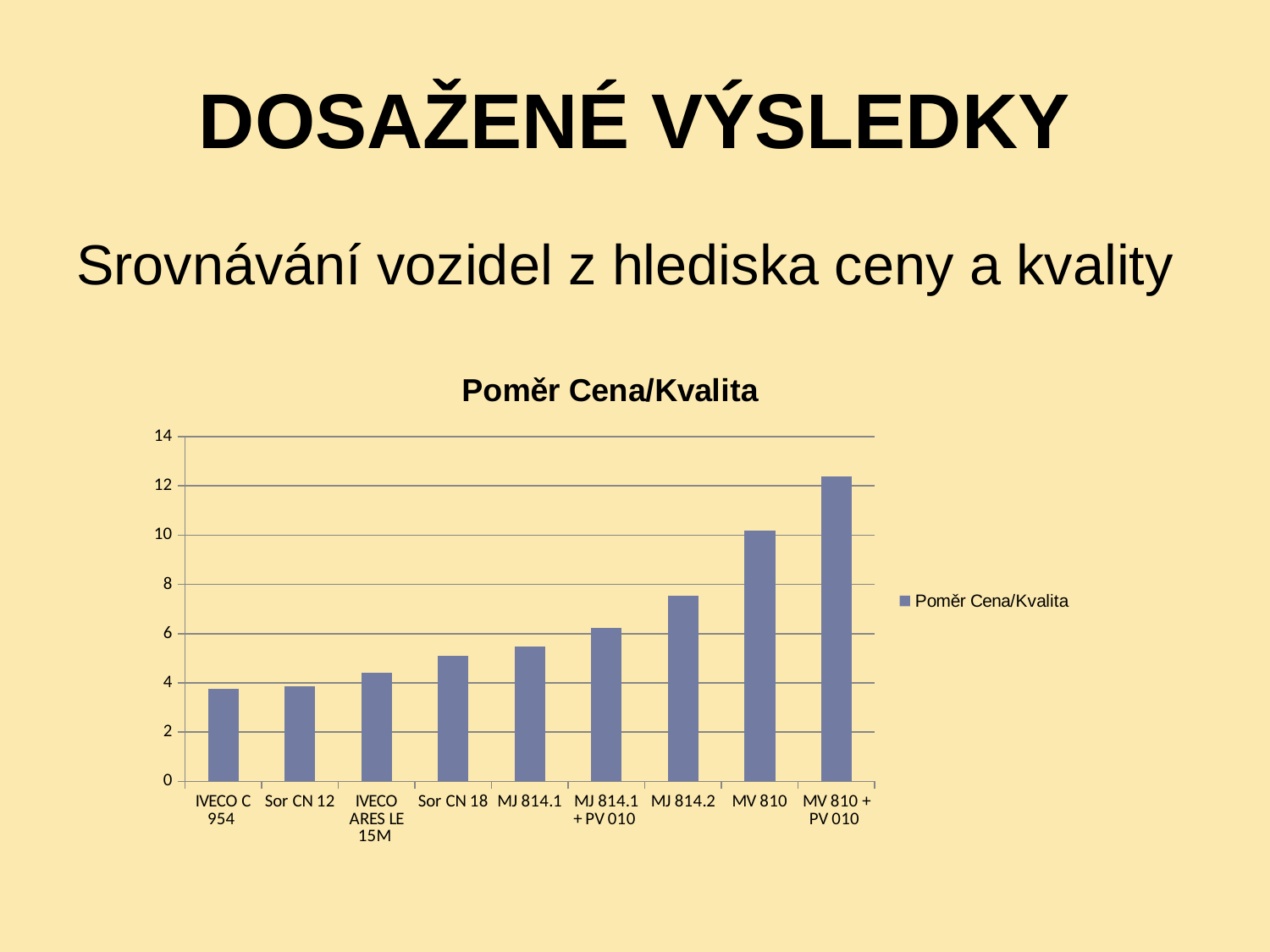
What kind of chart is shown on the slide? bar chart Is the value for Sor CN 18 greater or less than 4? greater Is the value for MJ 814.2 greater or less than 8? less What is the title of the chart? Poměr Cena/Kvalita Is the value for MV 810 + PV 010 greater or less than 12? greater Which vehicle has the highest Poměr Cena/Kvalita value? MV 810 + PV 010 Which has a larger value, MV 810 or MJ 814.2? MV 810 How many vehicle categories are plotted on the x axis? 9 Do the values rise or fall from left to right along the x axis? rise How many series does the legend list? 1